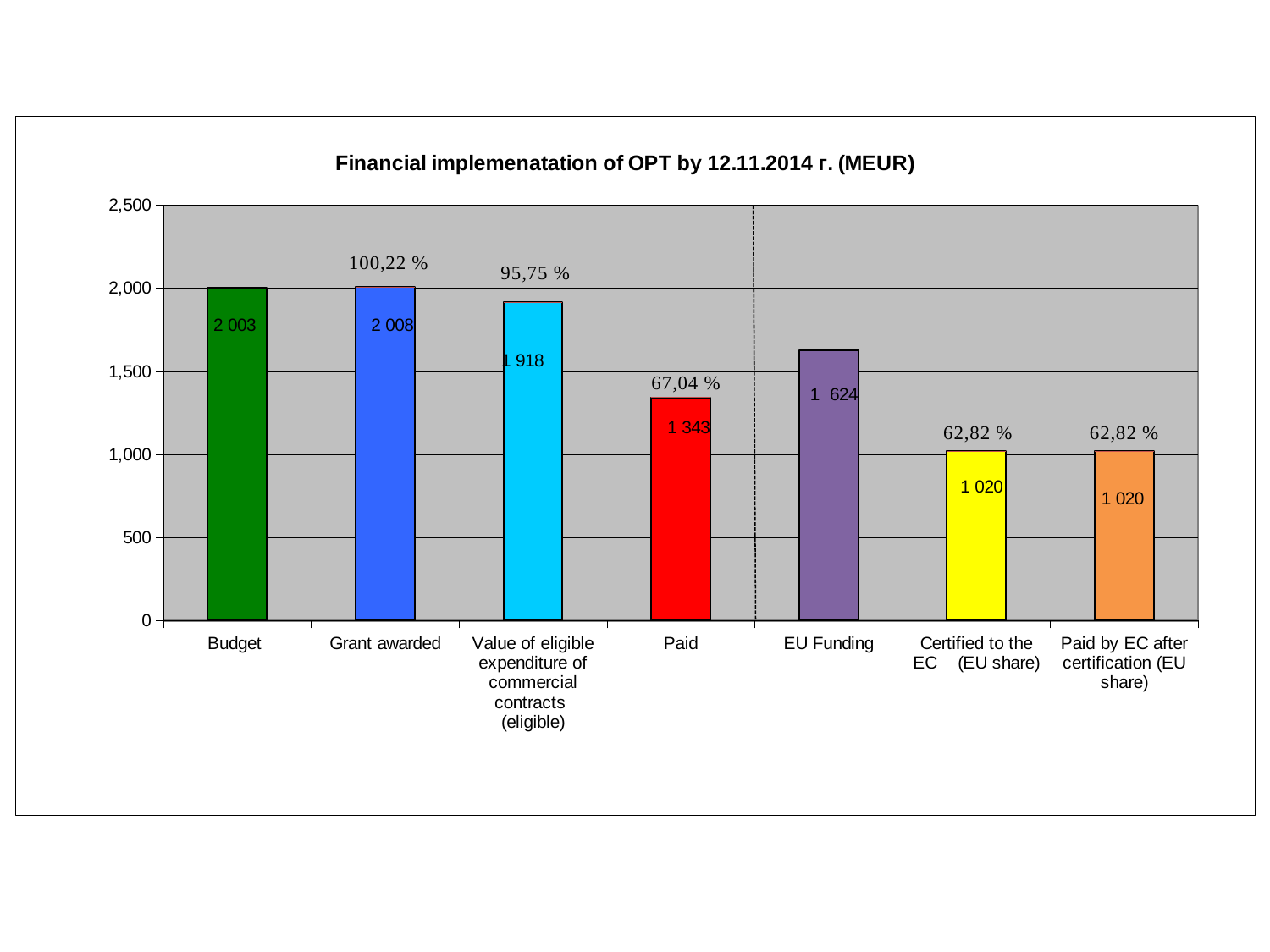
What percentage is shown above the Grant awarded bar? 100,22 % Is the value for Paid greater or less than 1,500? less What is the value for Certified to the EC (EU share)? 1 020 Which category has the lowest value? Certified to the EC (EU share) and Paid by EC after certification (EU share), both 1 020 What is the difference between Grant awarded and Paid? 665 What is the value for EU Funding? 1 624 What type of chart is shown? bar chart How many bars are shown in the chart? 7 What is the value for Paid? 1 343 What is the value for Budget? 2 003 Which is larger, Value of eligible expenditure of commercial contracts (eligible) or EU Funding? Value of eligible expenditure of commercial contracts (eligible) Which category has the highest value? Grant awarded